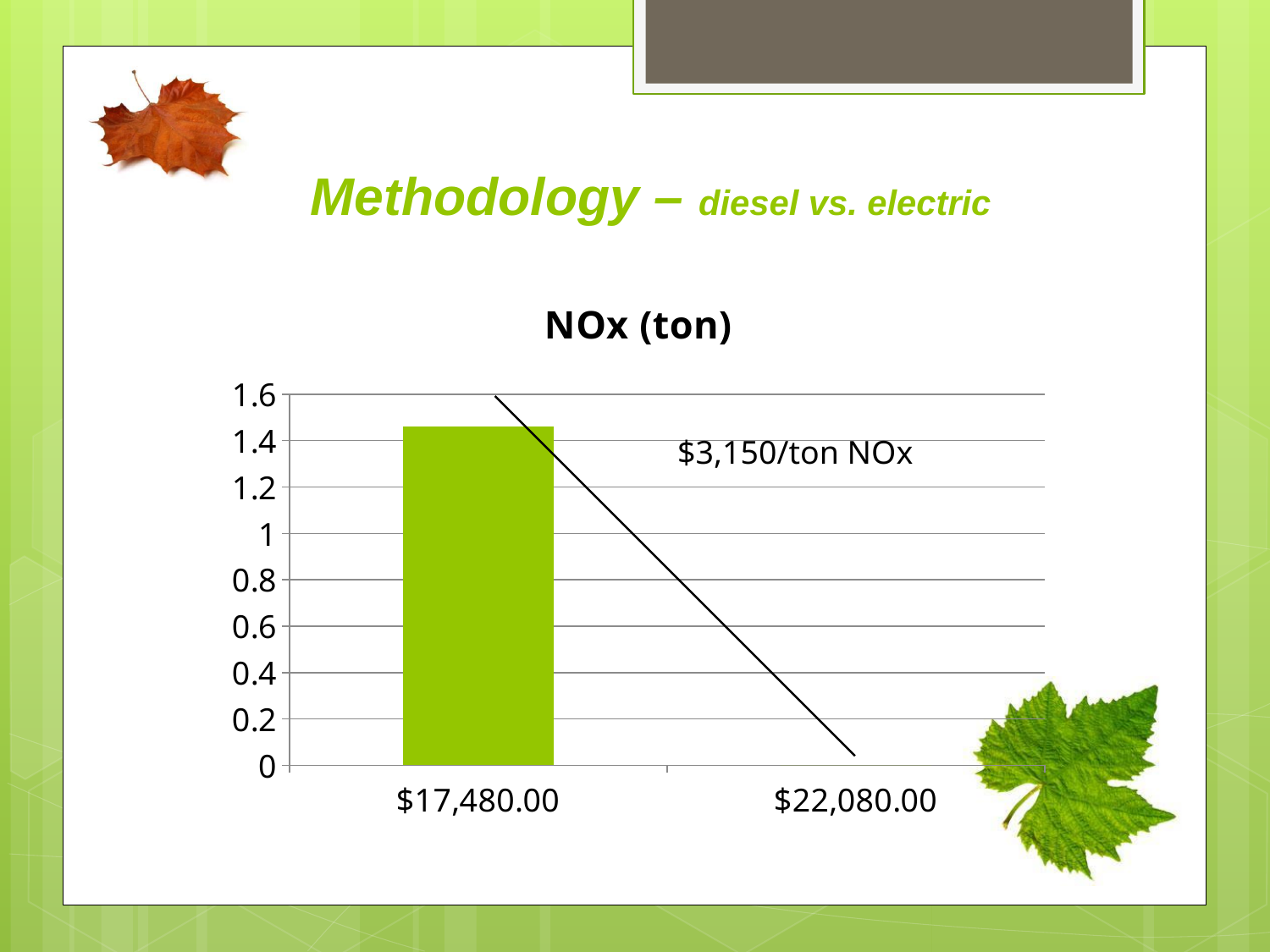
Which category has the highest NOx value? $17,480.00 What is the highest value labelled on the y axis of the chart? 1.6 What is the title of the chart? NOx (ton) Is the value for $22,080.00 greater or less than 0.2? less Is the value for $17,480.00 greater or less than 1.6? less Which category has the lowest NOx value? $22,080.00 What kind of chart is shown on the slide? bar chart What text annotation is printed inside the chart area? $3,150/ton NOx Which is larger, the value for $17,480.00 or the value for $22,080.00? $17,480.00 Do the NOx values rise or fall from left to right along the x axis? fall Is the value for $17,480.00 greater or less than 1.2? greater How many categories are shown on the x axis of the chart? 2